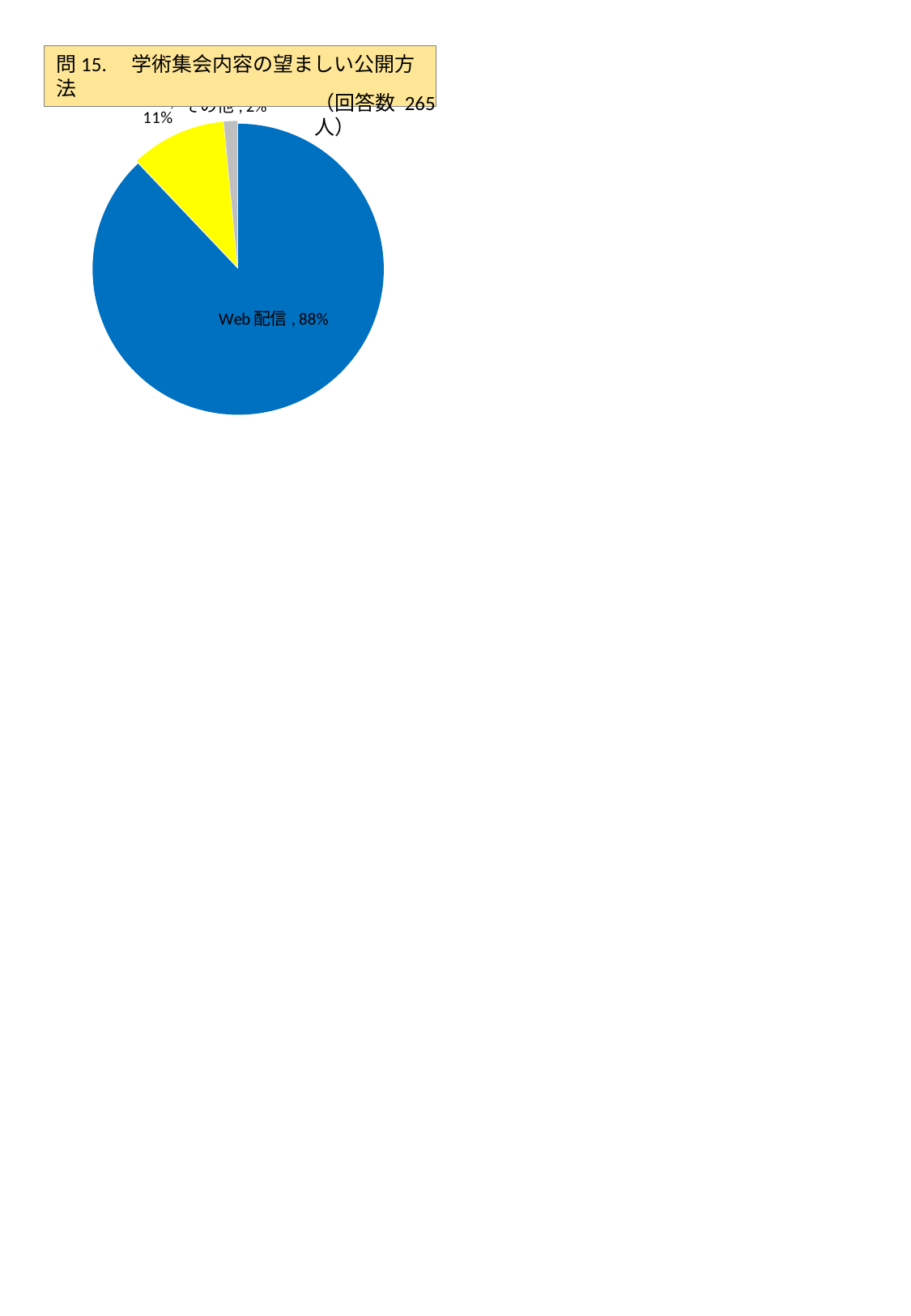
Is the share for Web配信 greater or less than 50%? greater How many slices does the pie chart have? 3 Which category has the smallest slice of the pie? その他 How many respondents (回答数) does the slide state for this question? 265人 Which is larger, the share for Web配信 or the share for その他? Web配信 What colour is the Web配信 slice of the pie? blue What is the value shown for その他? 2% What kind of chart is shown on the slide? pie chart What share of the pie does Web配信 account for? 88% What is the difference in percentage points between Web配信 and その他? 86% Which category has the largest slice of the pie? Web配信